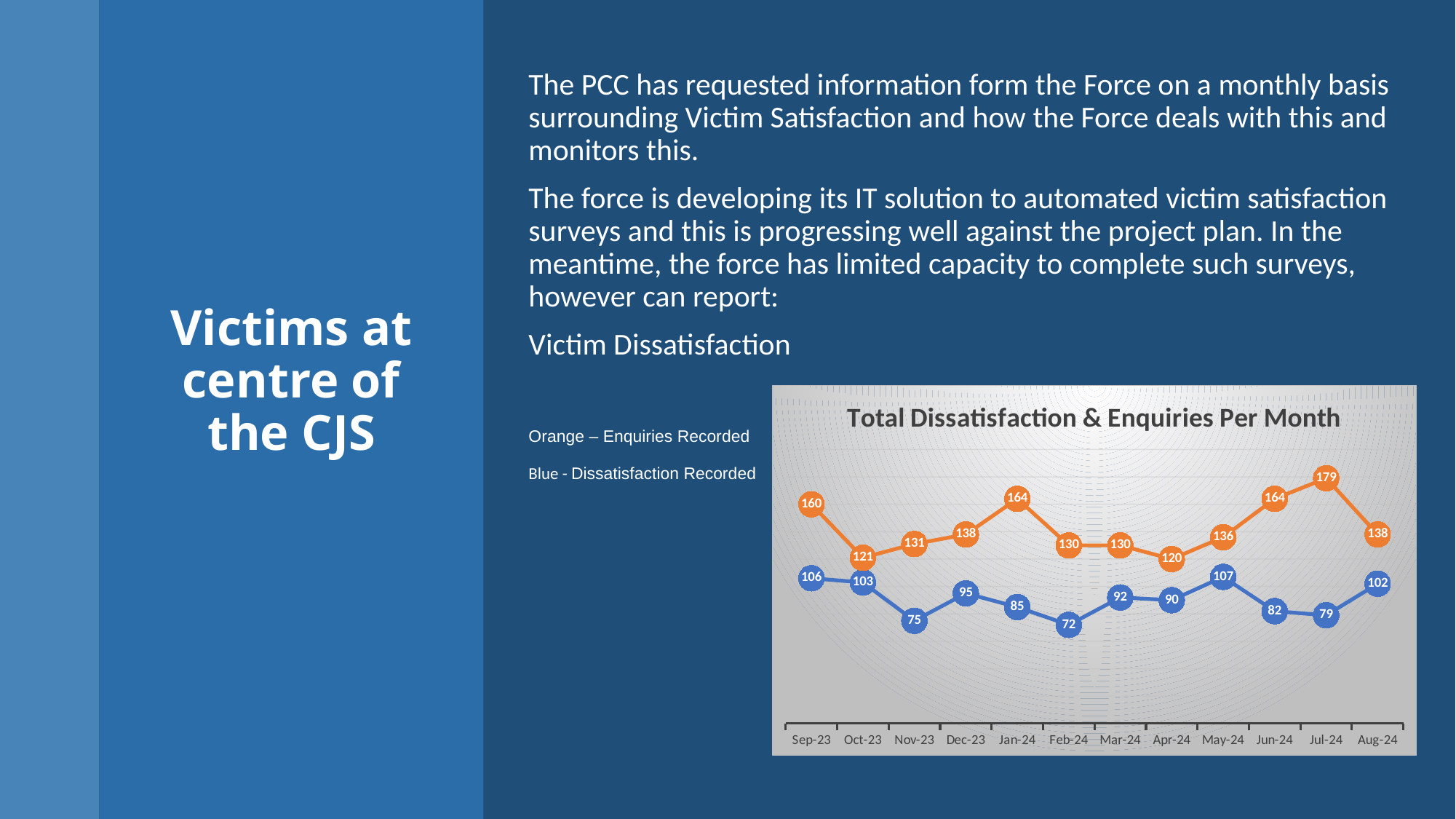
How many data series are plotted in the chart? 2 What kind of chart is shown on the slide? line chart How many months are plotted along the x axis of the chart? 12 Does Enquiries Recorded (orange line) rise or fall from Jul-24 to Aug-24? fall Which colour represents Dissatisfaction Recorded in the chart? Blue What is the value of Enquiries Recorded (orange line) for Jul-24? 179 In which month is Dissatisfaction Recorded (blue line) lowest? Feb-24 What is the difference between Enquiries Recorded and Dissatisfaction Recorded in Jul-24? 100 What is the value of Dissatisfaction Recorded (blue line) for Feb-24? 72 What is the title of the chart? Total Dissatisfaction & Enquiries Per Month Which is larger: Dissatisfaction Recorded in Sep-23 or in Aug-24? Sep-23 In which month is Enquiries Recorded (orange line) highest? Jul-24